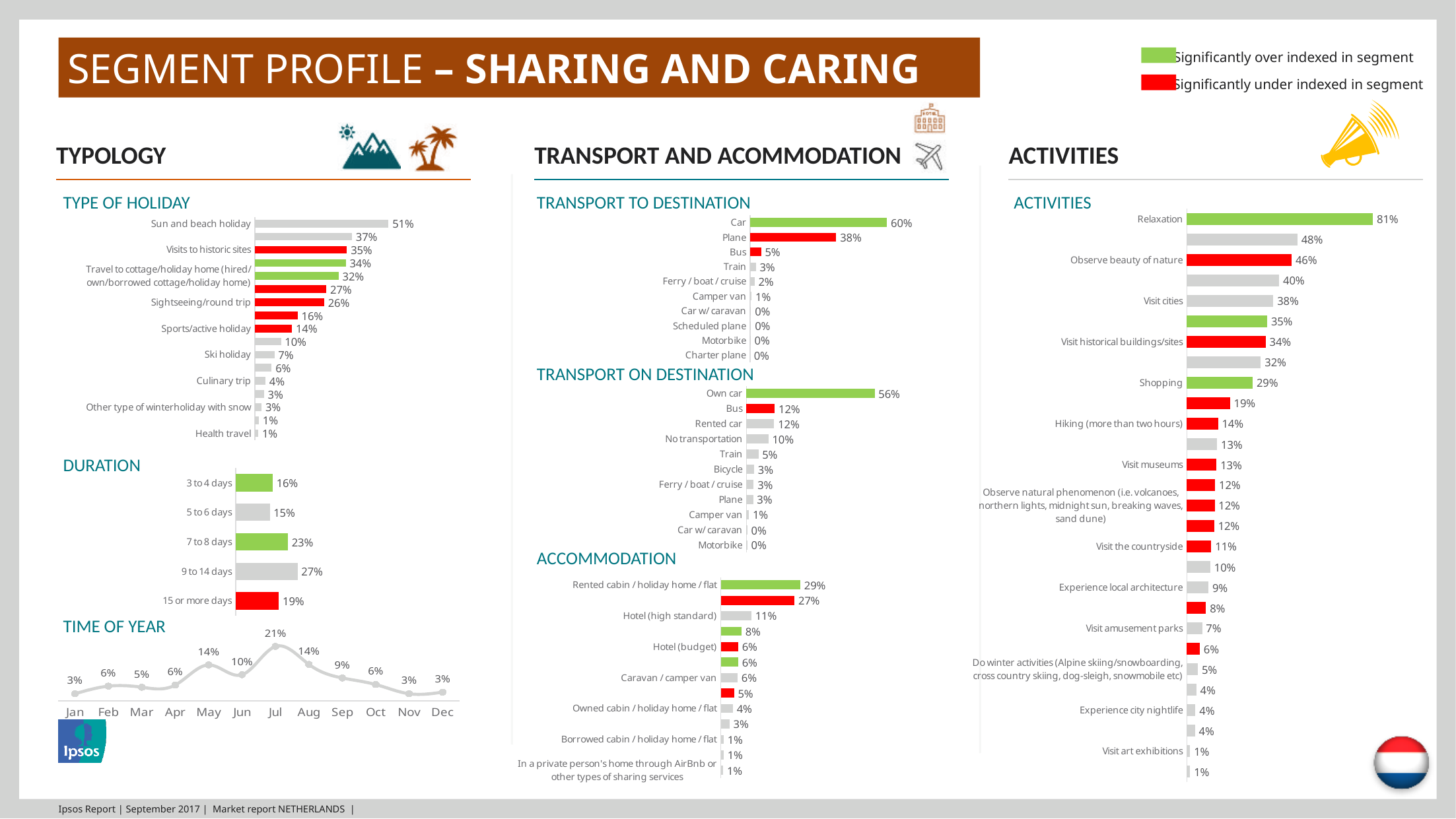
In the Transport on Destination chart, what is the value for Own car? 56% In the Transport to Destination chart, what is the value for Car? 60% In the Duration chart, which duration category has the highest value? 9 to 14 days What kind of chart is the Time of Year chart? Line chart In the Duration chart, what is the difference between 7 to 8 days and 5 to 6 days? 8% In the Type of Holiday chart, what is the value for Sun and beach holiday? 51% In the Activities chart, what is the value for Relaxation? 81% In the Activities chart, what is the difference between Relaxation and Observe beauty of nature? 35% In the Accommodation chart, which is larger: Rented cabin / holiday home / flat or Hotel (high standard)? Rented cabin / holiday home / flat In the Time of Year chart, what is the value for May? 14% How many months are plotted in the Time of Year chart? 12 In the Time of Year chart, which month has the highest value? Jul